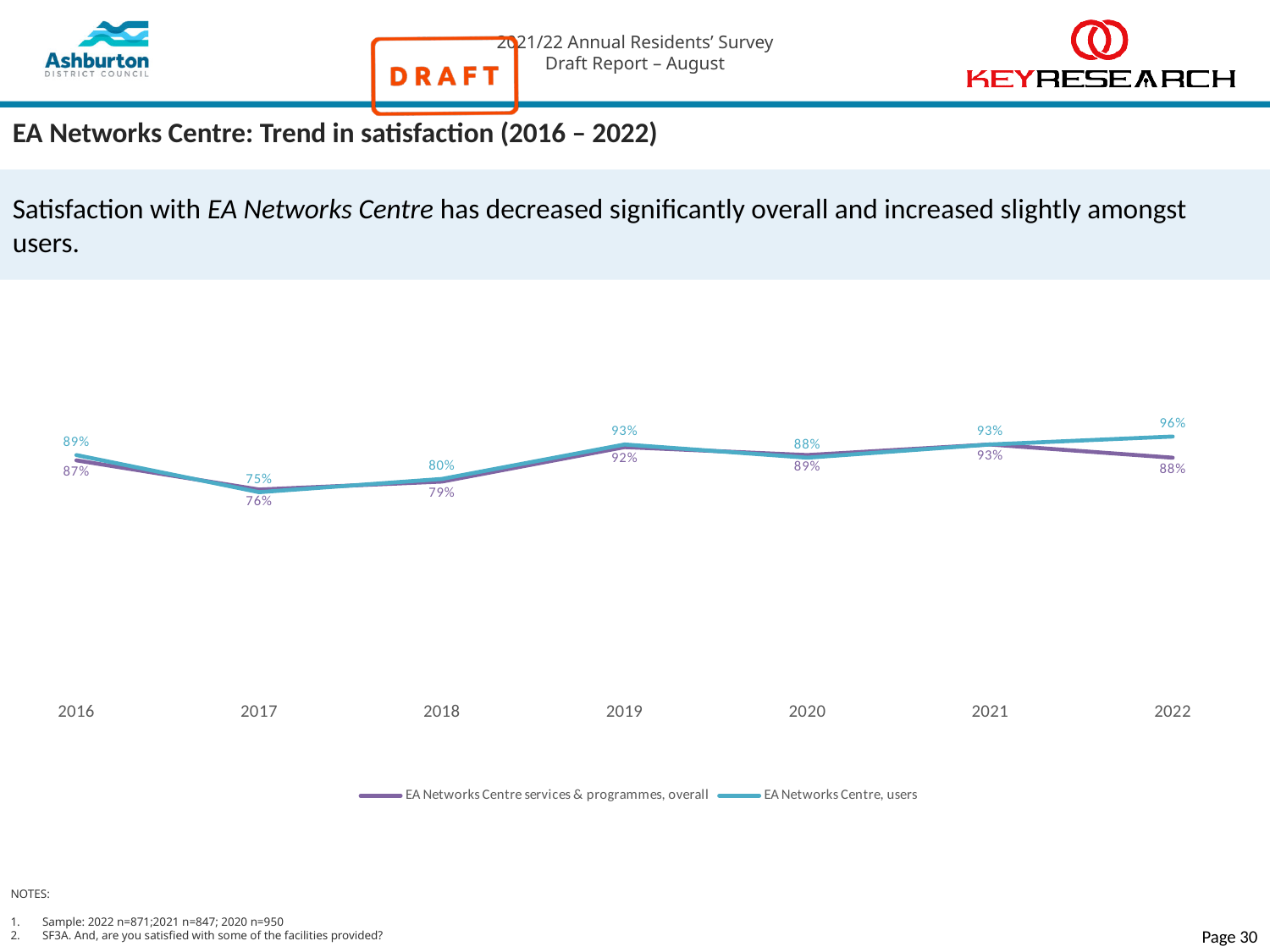
What is the difference between the users value and the overall value in 2022? 8 percentage points How many years are plotted along the x axis? 7 What is the satisfaction value for EA Networks Centre, users in 2016? 89% In which year is the EA Networks Centre, users series at its highest? 2022 How many series does the legend list? 2 What type of chart is shown on the slide? Line chart Does the EA Networks Centre, users series rise or fall from 2020 to 2022? Rise In which year is the EA Networks Centre, users series at its lowest? 2017 What is the satisfaction value for EA Networks Centre services & programmes, overall in 2022? 88% What is the satisfaction value for EA Networks Centre, users in 2022? 96% What is the title of the chart on the slide? EA Networks Centre: Trend in satisfaction (2016 – 2022) Which series has the higher value in 2022, users or overall? EA Networks Centre, users